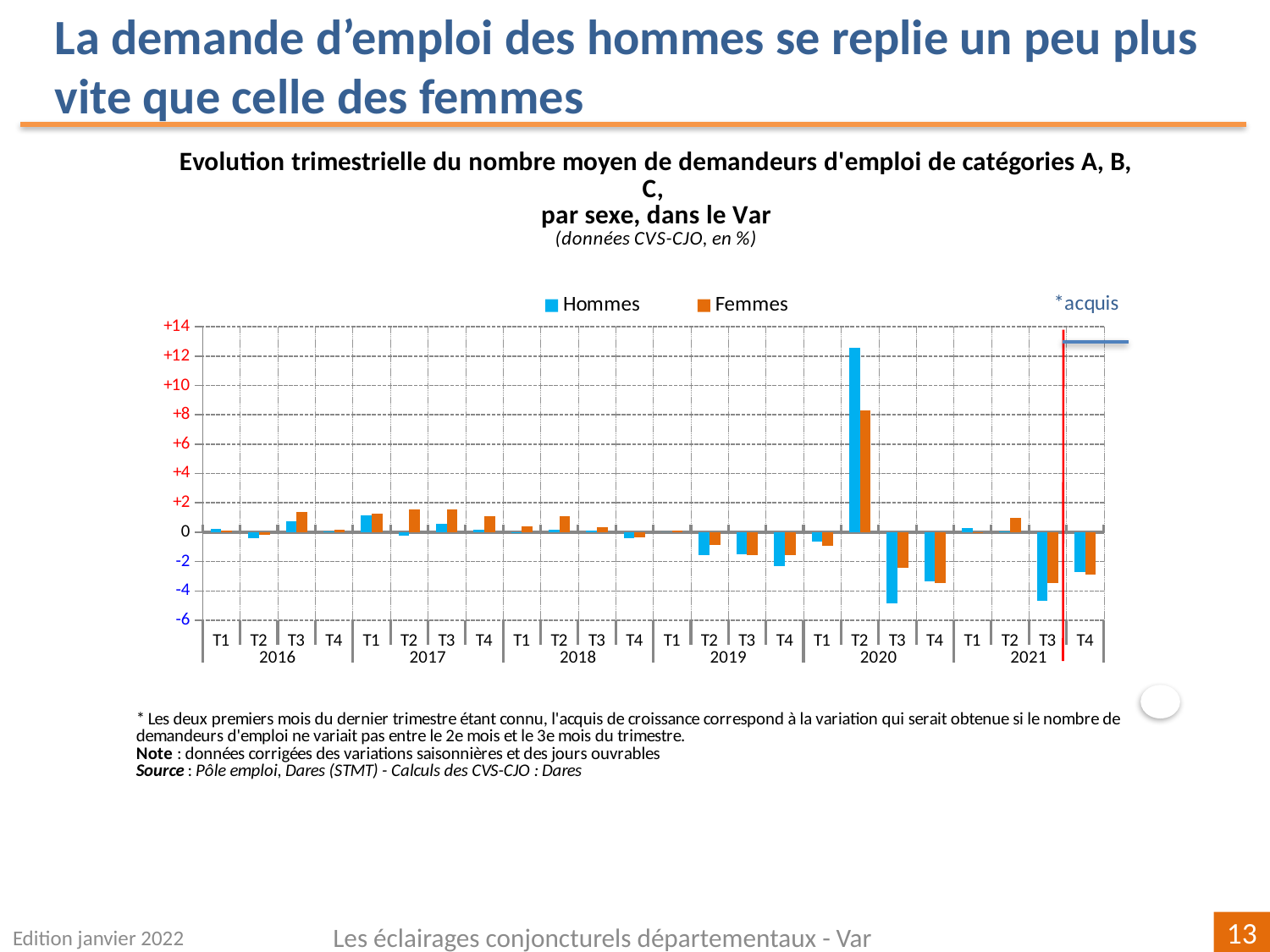
In which quarter does the Hommes series reach its highest value? T2 2020 Is the value for Femmes in T3 2021 greater or less than -2? less How many series does the legend list? 2 In T2 2020, which series has the larger value, Hommes or Femmes? Hommes Which colour represents the Femmes series in the legend? orange Is the value for Hommes in T2 2020 greater or less than +10? greater What kind of chart is shown on the slide? bar chart How many quarters (bars per series) are plotted on the x axis? 24 In which quarter does the Femmes series reach its highest value? T2 2020 In T3 2020, which series shows the larger decrease, Hommes or Femmes? Hommes Is the value for Femmes in T2 2020 greater or less than +6? greater